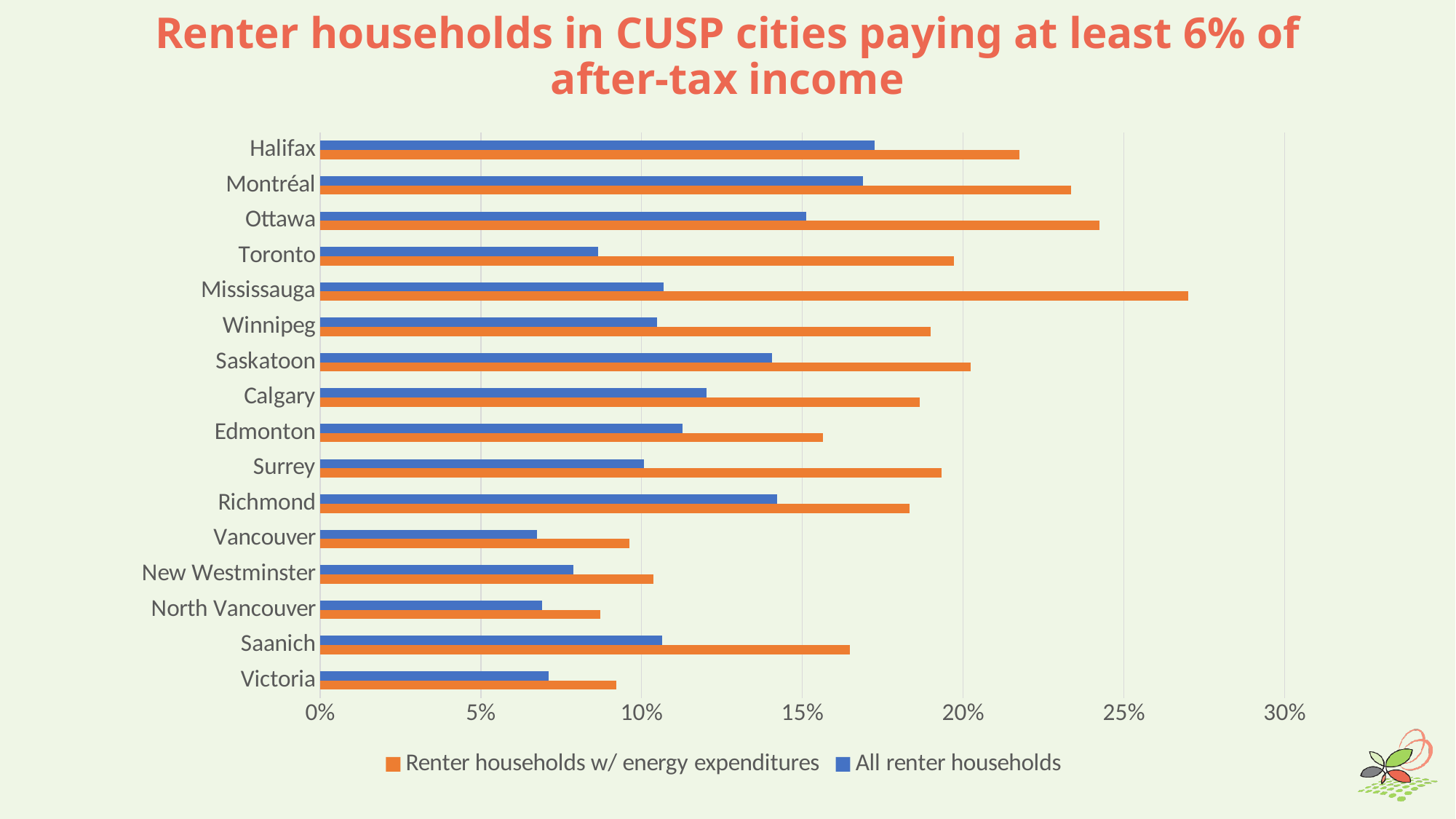
Which city has the highest value for renter households with energy expenditures? Mississauga How many series does the legend list? 2 Is the value for renter households with energy expenditures in Mississauga greater or less than 25%? greater Is the value for all renter households in Saskatoon greater or less than 15%? less Is the value for renter households with energy expenditures in Halifax greater or less than 20%? greater Which colour represents the 'All renter households' series? Blue What type of chart is shown on the slide? Bar chart Which is larger for all renter households: Richmond or Surrey? Richmond Which is larger for renter households with energy expenditures: Mississauga or Toronto? Mississauga How many cities are listed on the chart? 16